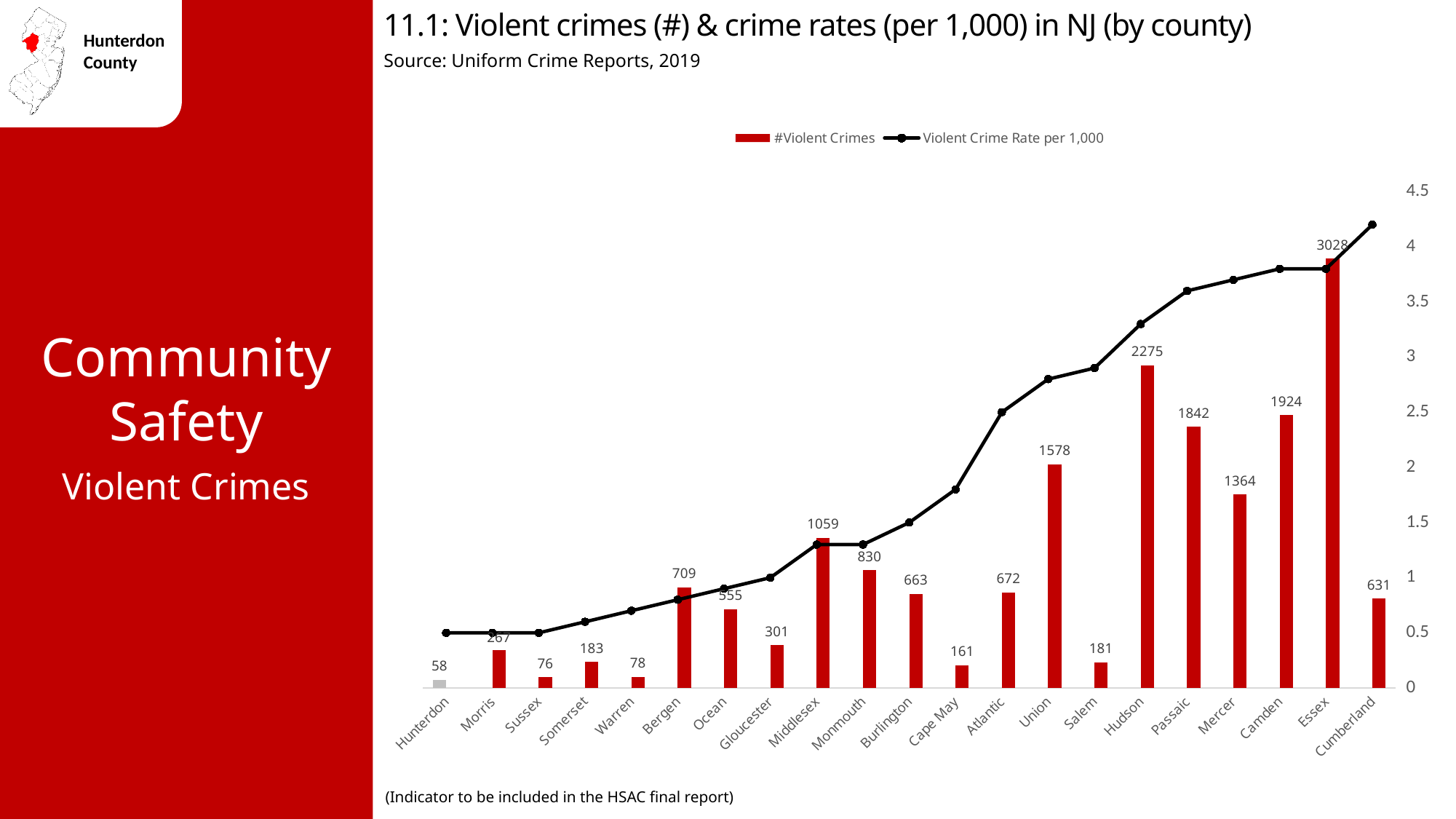
How many violent crimes are shown for Hunterdon County? 58 How many series does the legend list? 2 Which county has more violent crimes, Camden or Passaic? Camden What is the difference in the number of violent crimes between Essex and Hudson? 753 Does the violent crime rate per 1,000 generally rise or fall from Hunterdon to Cumberland along the x axis? Rise How many counties are shown on the x axis? 21 What is the number of violent crimes for Middlesex? 1059 Which county has the highest number of violent crimes? Essex Is the violent crime rate per 1,000 for Hunterdon greater or less than 1? less Which county has the lowest number of violent crimes? Hunterdon What kind of chart is used to show the violent crime rate per 1,000? Line chart Is the violent crime rate per 1,000 for Cumberland greater or less than 4? greater